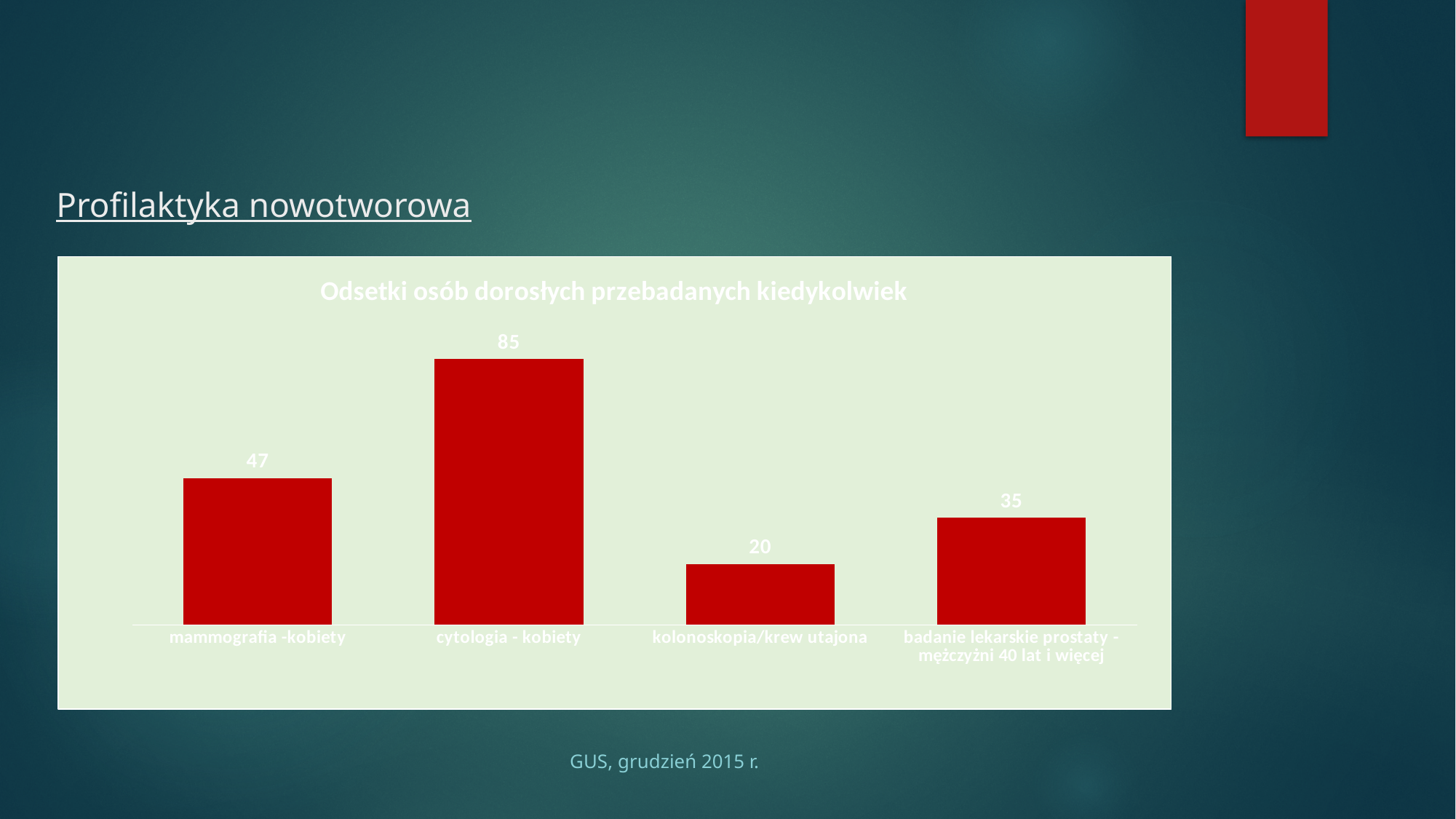
What is the value for cytologia - kobiety? 85 What kind of chart is shown on the slide? bar chart Which category has the lowest value? kolonoskopia/krew utajona What is the title of the chart? Odsetki osób dorosłych przebadanych kiedykolwiek What is the difference between the values for cytologia - kobiety and mammografia -kobiety? 38 What is the value for badanie lekarskie prostaty - mężczyźni 40 lat i więcej? 35 What is the value for kolonoskopia/krew utajona? 20 What is the value for mammografia -kobiety? 47 Which category has the highest value? cytologia - kobiety Which is larger, the value for mammografia -kobiety or the value for badanie lekarskie prostaty - mężczyźni 40 lat i więcej? mammografia -kobiety How many categories are shown in the chart? 4 What is the difference between the values for badanie lekarskie prostaty - mężczyźni 40 lat i więcej and kolonoskopia/krew utajona? 15